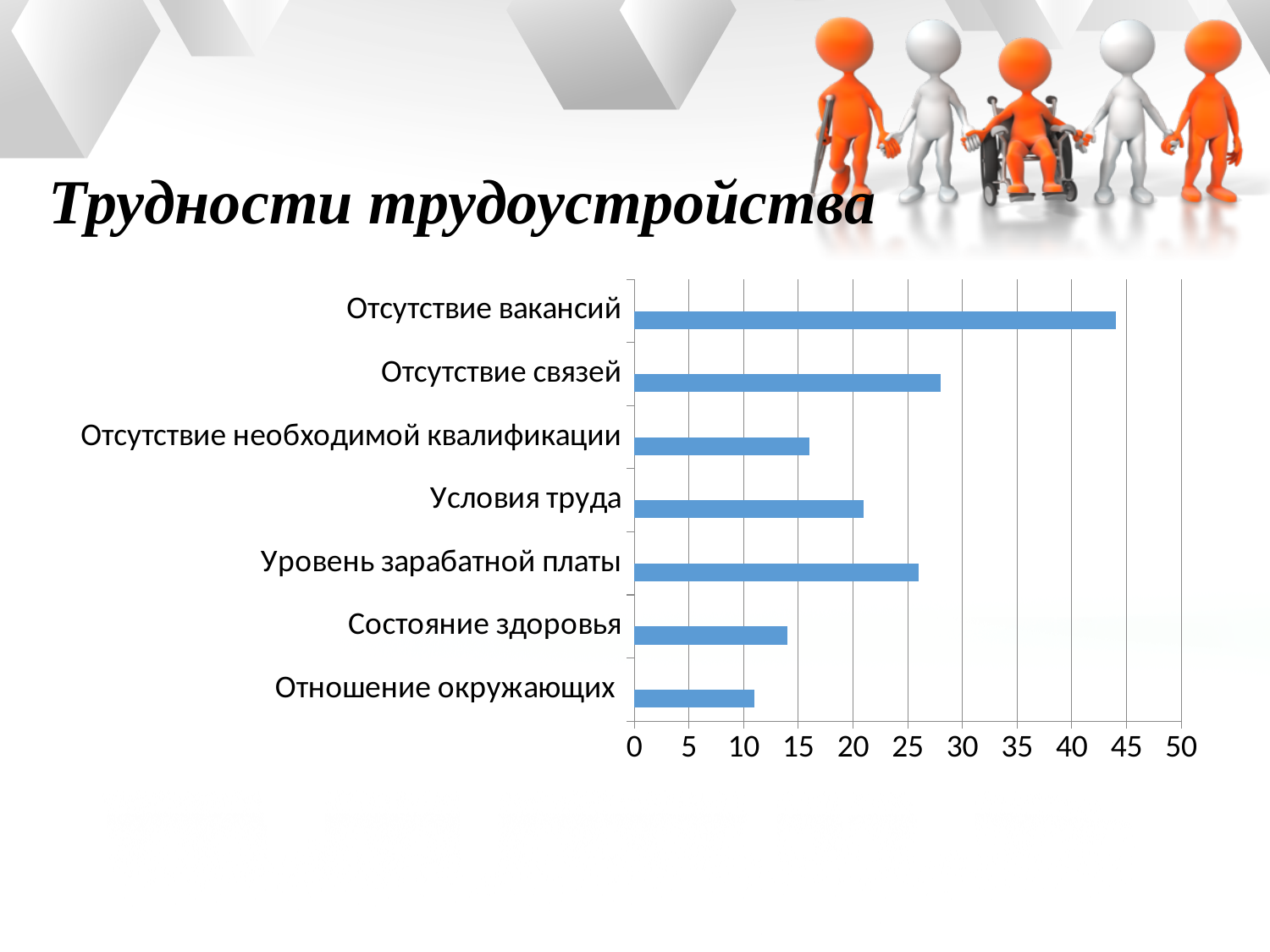
Which is larger: the value for Состояние здоровья or the value for Условия труда? Условия труда Is the value for Уровень зарабатной платы greater or less than 20? greater Is the value for Отсутствие вакансий greater or less than 40? greater Is the value for Отсутствие необходимой квалификации greater or less than 20? less Which is larger: the value for Условия труда or the value for Отсутствие необходимой квалификации? Условия труда What is the title of the slide above the chart? Трудности трудоустройства Which category has the highest value in the chart? Отсутствие вакансий What kind of chart is shown on the slide? Bar chart Which category has the lowest value in the chart? Отношение окружающих How many categories are plotted in the chart? 7